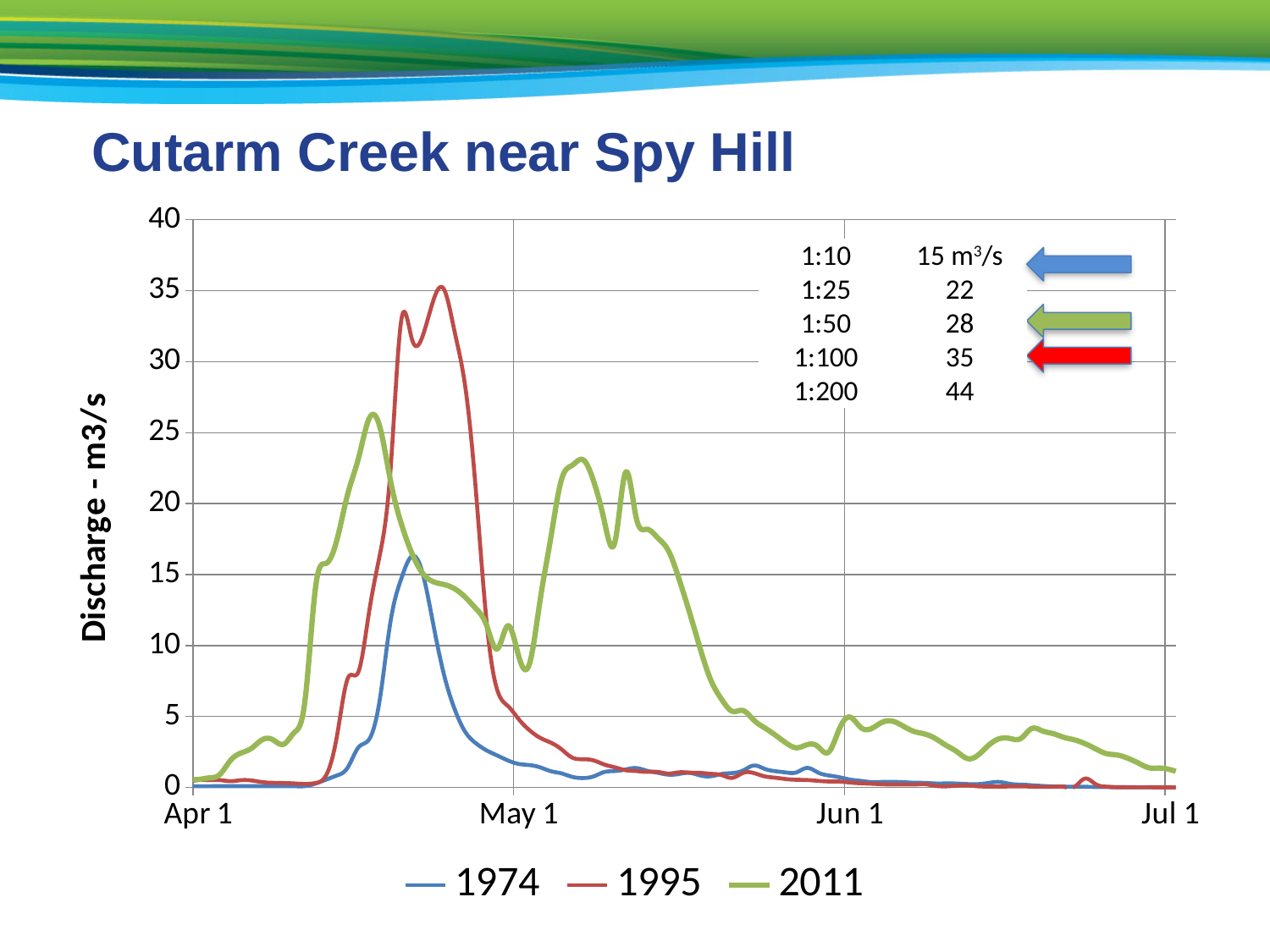
Which series has the lowest peak discharge? 1974 What is the title of the y axis? Discharge - m3/s What kind of chart is shown on the slide? line chart Which series reaches the highest peak discharge? 1995 Is the value for the 1995 series at Jun 1 greater or less than 5? less How many series does the legend list? 3 What colour is the line for the 2011 series? green Is the peak value for the 2011 series greater or less than 20? greater Which series has the larger peak, 2011 or 1974? 2011 Does the 1995 series rise or fall between May 1 and Jun 1? fall Is the peak value for the 1974 series greater or less than 20? less